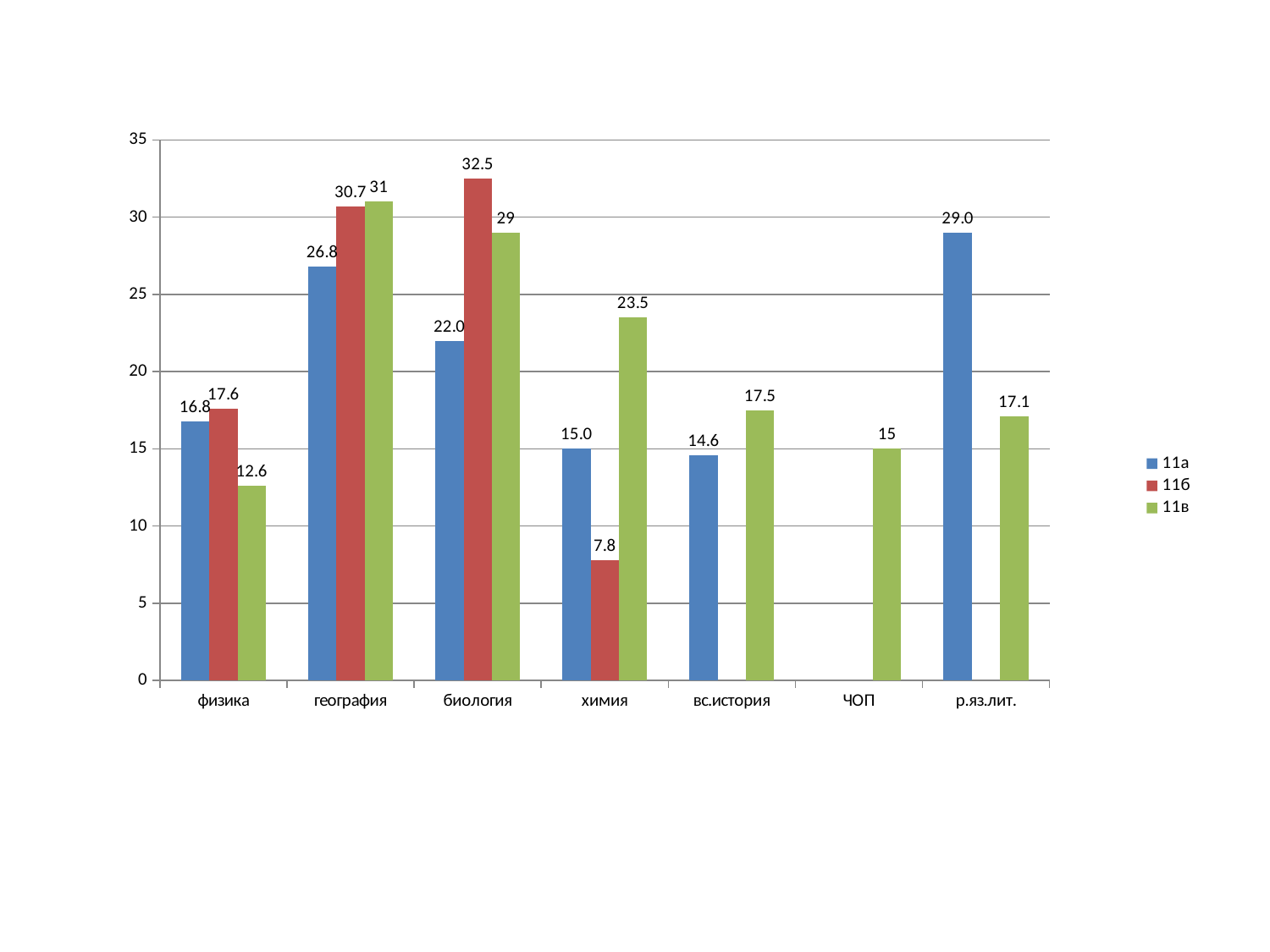
What is the value for 11в in химия? 23.5 Which category has the highest value for 11б? биология Which is larger in биология: the value for 11а or for 11в? 11в How many series does the legend list? 3 What kind of chart is this? bar chart Which category has the lowest value for 11в? физика Is the value for 11а in вс.история greater or less than 15? less What is the value for 11б in география? 30.7 Which colour represents the 11в series? green What is the value for 11а in р.яз.лит.? 29.0 How many categories are shown on the x axis? 7 What is the difference between the 11а and 11б values in химия? 7.2